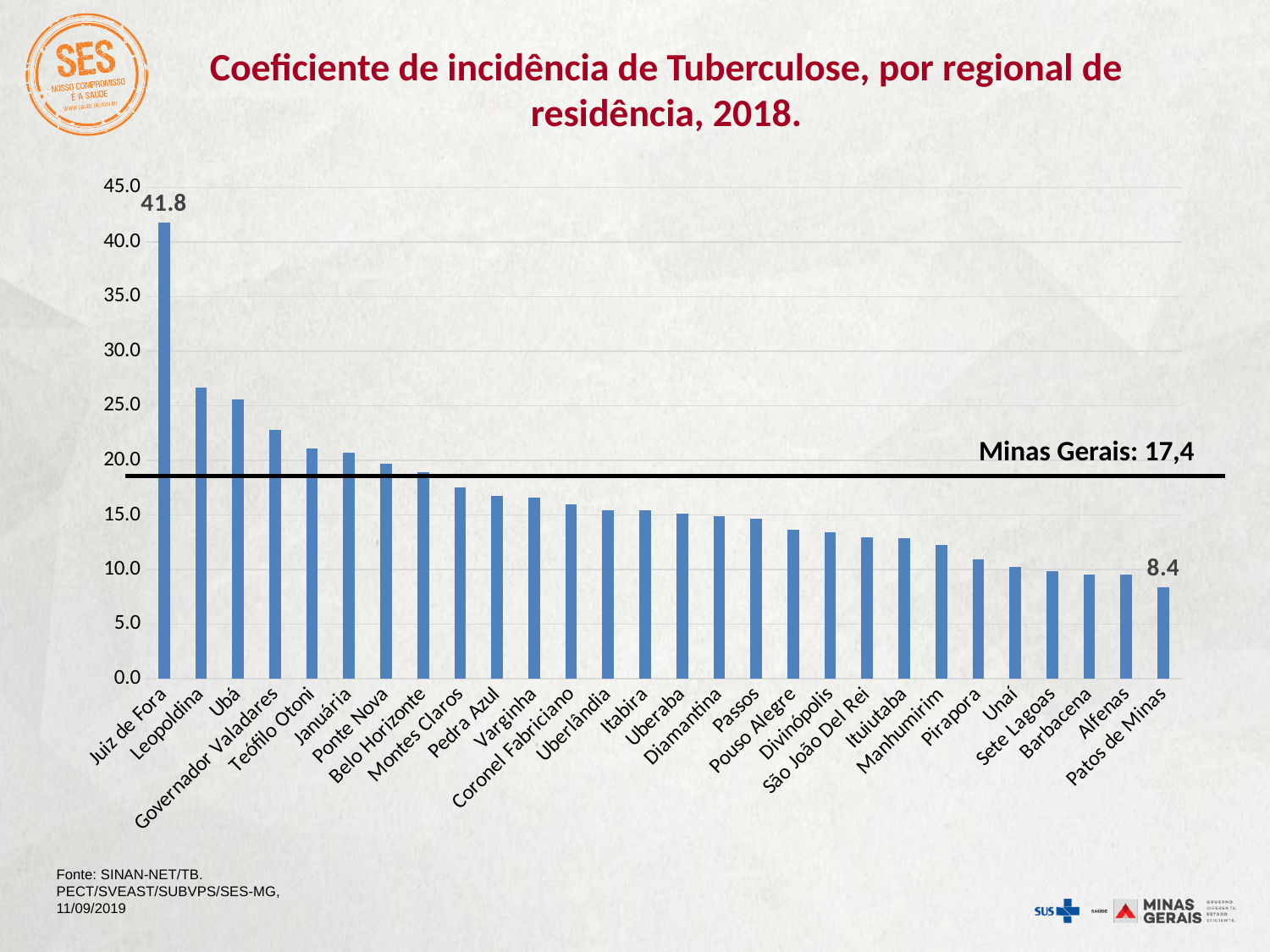
Which regional has the highest incidence coefficient? Juiz de Fora Which has a higher incidence coefficient, Leopoldina or Uberaba? Leopoldina What is the tuberculosis incidence coefficient for Patos de Minas? 8.4 What type of chart is shown on the slide? bar chart Is the value for Belo Horizonte greater or less than 20? less Is the value for Barbacena greater or less than 10? less Which regional has the lowest incidence coefficient? Patos de Minas How many regionals are plotted on the chart? 28 What value is shown for Minas Gerais by the horizontal reference line? 17,4 What is the difference between the incidence coefficients of Juiz de Fora and Patos de Minas? 33.4 Is the value for Leopoldina greater or less than 25? greater What is the tuberculosis incidence coefficient for Juiz de Fora? 41.8